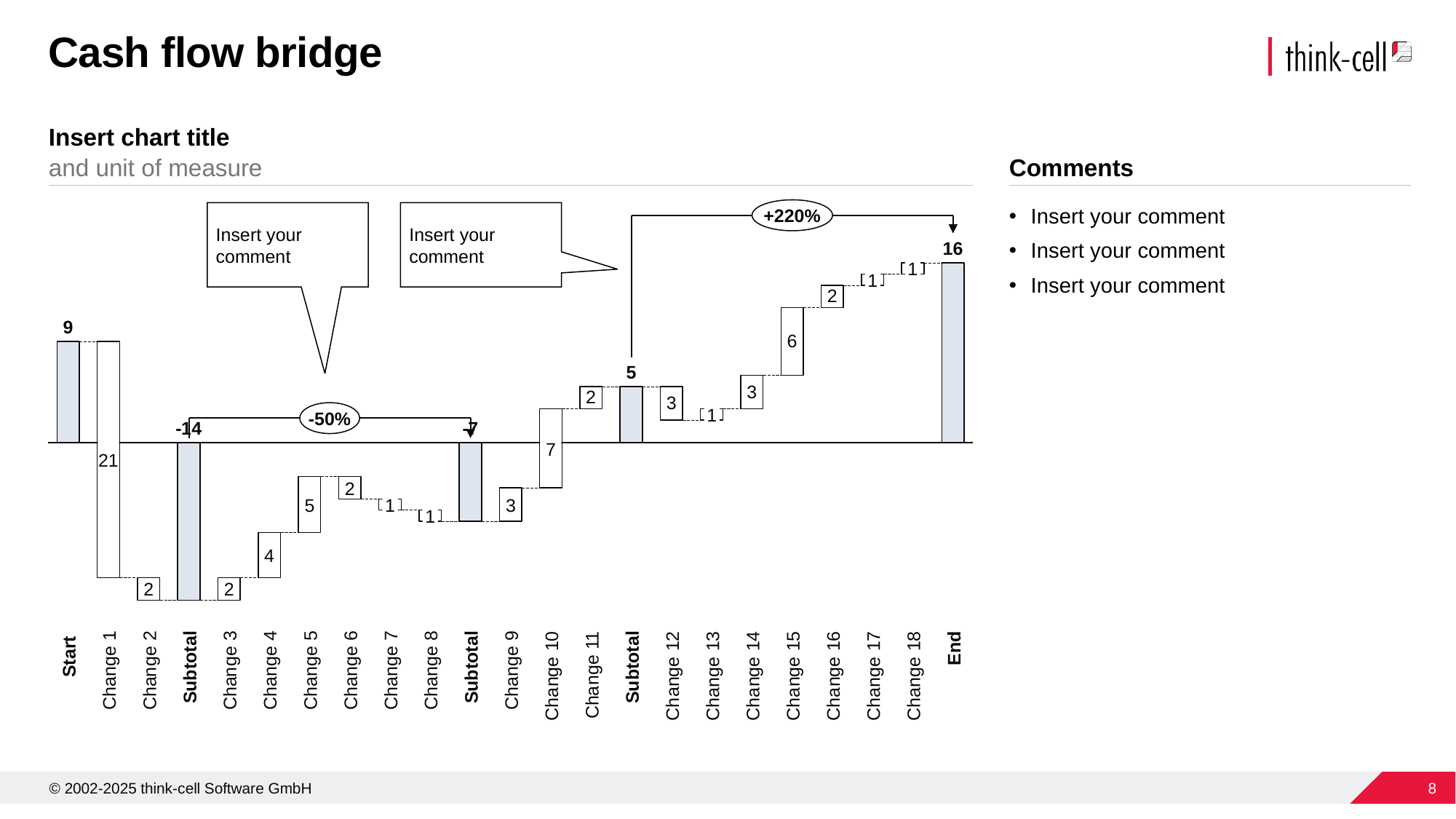
What is the value of the Start bar? 9 What is the value of the third Subtotal bar (the one before Change 12)? 5 What is the value labelled on the Change 10 bar? 7 What is the value labelled on the Change 15 bar? 6 What is the difference between the End value and the Start value? 7 What is the value of the End bar? 16 What percentage is shown in the annotation arrow from the third Subtotal to the End bar? +220% How many categories are shown on the x axis? 23 What is the value labelled on the Change 1 bar? 21 What kind of chart is shown on the slide? Waterfall chart Which has the larger labelled value, Change 4 or Change 5? Change 5 Which change bar has the largest labelled value? Change 1